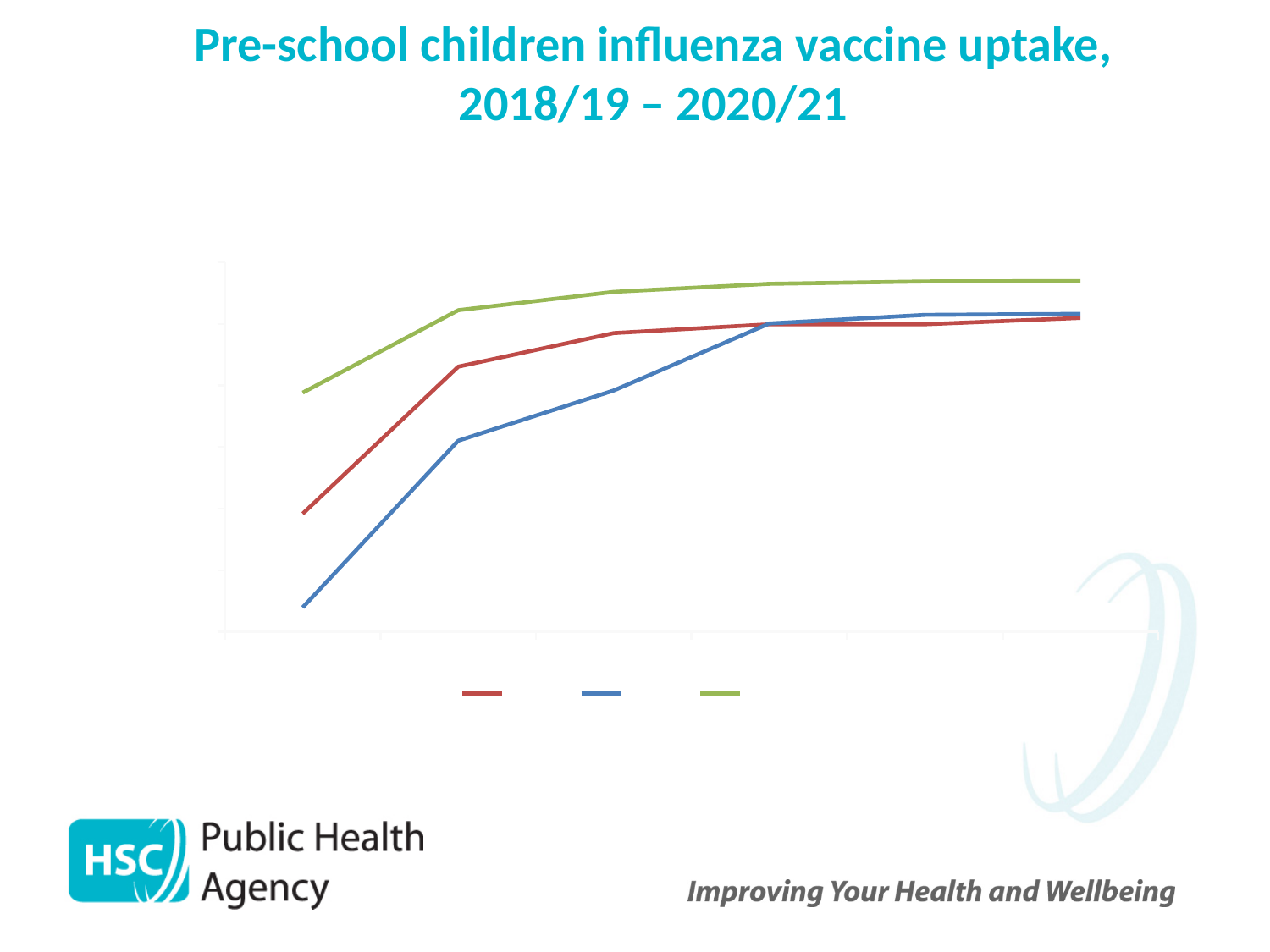
How many series does the legend list? 3 How many points are plotted on each line? 6 At the second point, is the red line or the blue line higher? red What colours are the three lines in the chart? red, blue and green What is the title of the chart on the slide? Pre-school children influenza vaccine uptake, 2018/19 – 2020/21 Which line shows the largest increase between its first and last points: red, blue or green? blue Do the values of the green line rise or fall along the x axis? rise Do the values of the blue line rise or fall along the x axis? rise At the first point, is the green line or the blue line higher? green Which line is highest across the whole chart: red, blue or green? green What kind of chart is shown on the slide? line chart Which line has the lowest value at the first point: red, blue or green? blue